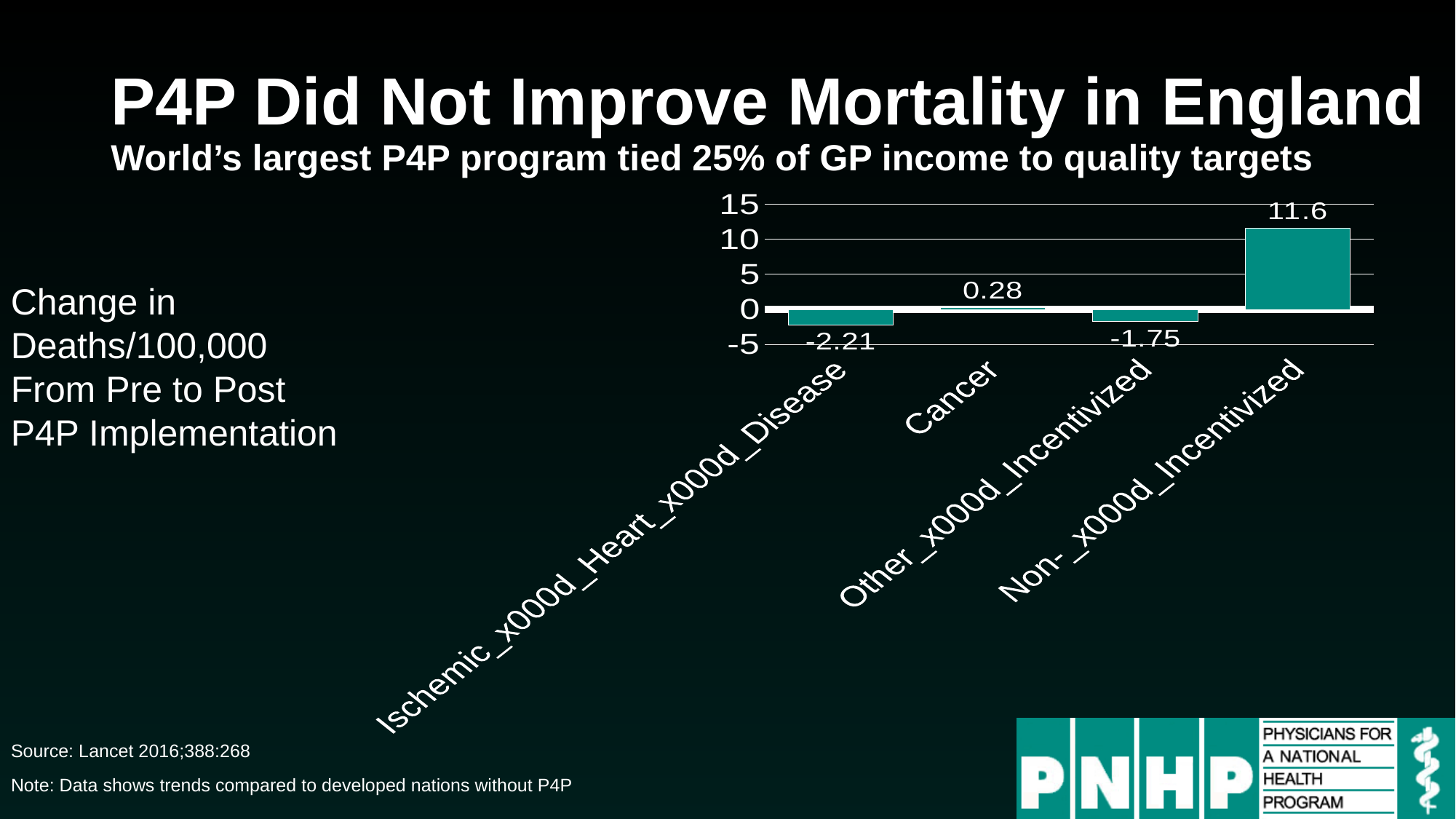
What is the change in deaths per 100,000 for Cancer? 0.28 What colour are the bars in the chart? teal Which category has the highest change in deaths per 100,000? Non-Incentivized What kind of chart is shown on the slide? bar chart What is the change in deaths per 100,000 for Ischemic Heart Disease? -2.21 What is the change in deaths per 100,000 for Non-Incentivized conditions? 11.6 Which is larger, the value for Cancer or the value for Other Incentivized? Cancer What is the change in deaths per 100,000 for Other Incentivized conditions? -1.75 Which category has the lowest change in deaths per 100,000? Ischemic Heart Disease How many categories are shown in the chart? 4 What is the difference between the Non-Incentivized value and the Cancer value? 11.32 Is the value for Non-Incentivized greater or less than 10? greater